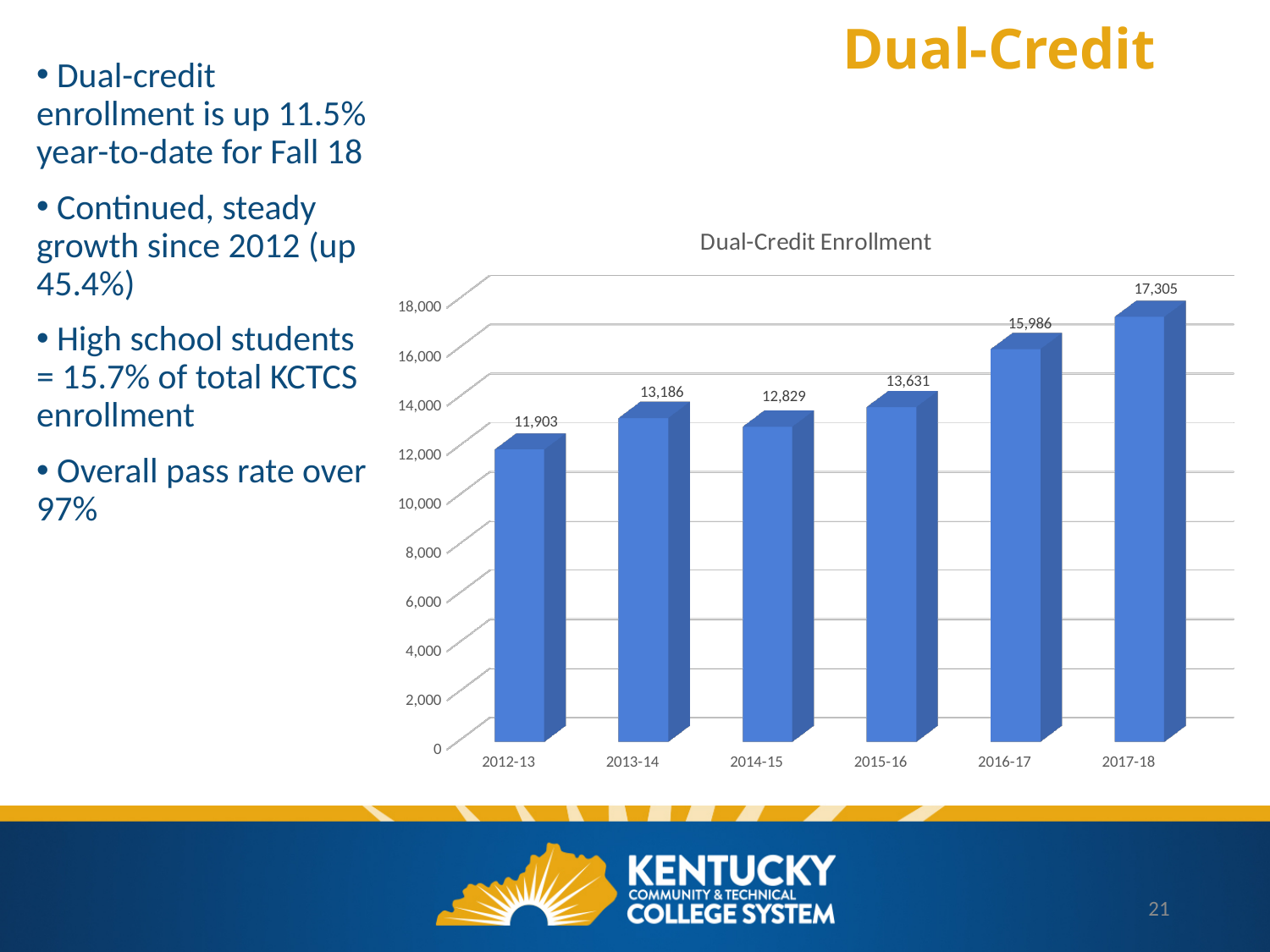
Which year has higher enrollment, 2013-14 or 2014-15? 2013-14 Which year has the highest dual-credit enrollment? 2017-18 What is the title of the chart? Dual-Credit Enrollment What is the difference in enrollment between 2013-14 and 2014-15? 357 What is the dual-credit enrollment for 2012-13? 11,903 What is the dual-credit enrollment for 2017-18? 17,305 What is the dual-credit enrollment for 2015-16? 13,631 How many academic years are shown on the chart? 6 Which year has the lowest dual-credit enrollment? 2012-13 Is the enrollment for 2016-17 greater or less than 14,000? greater What is the difference in enrollment between 2017-18 and 2016-17? 1,319 What kind of chart is used to show dual-credit enrollment? Bar chart